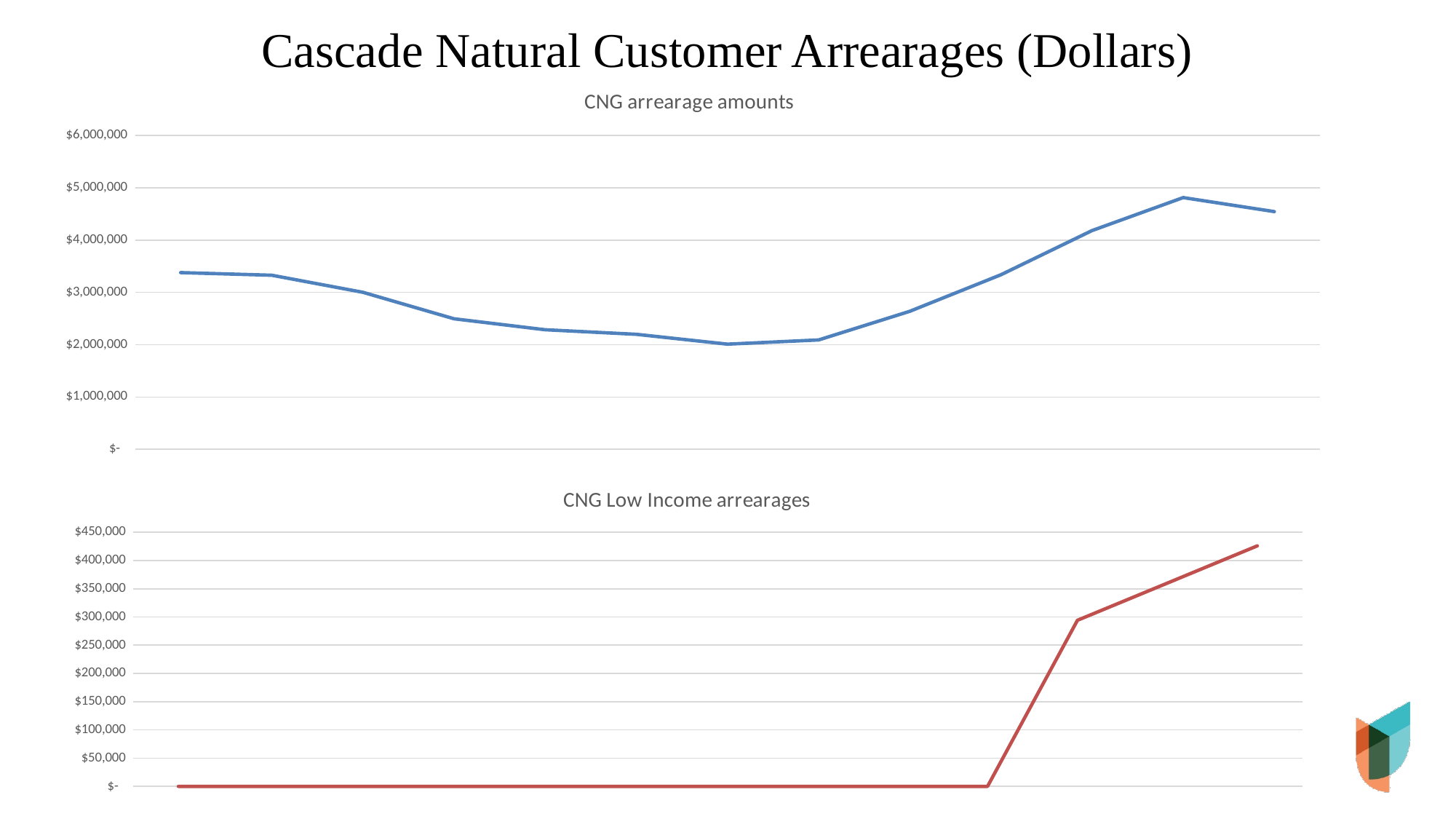
In the "CNG Low Income arrearages" chart, does the line rise or fall over its final points? rise In the "CNG arrearage amounts" chart, does the line end higher or lower than it starts? higher What kind of chart is the "CNG arrearage amounts" chart? line chart In the "CNG Low Income arrearages" chart, what value does the line sit at for the first part of the series? $- In the "CNG Low Income arrearages" chart, is the last point on the line greater or less than $350,000? greater In the "CNG arrearage amounts" chart, is the highest point on the line greater or less than $4,000,000? greater In the "CNG arrearage amounts" chart, is the first point on the line greater or less than $3,000,000? greater What kind of chart is the "CNG Low Income arrearages" chart? line chart How many charts are shown on the slide? 2 What colour is the line in the "CNG Low Income arrearages" chart? red